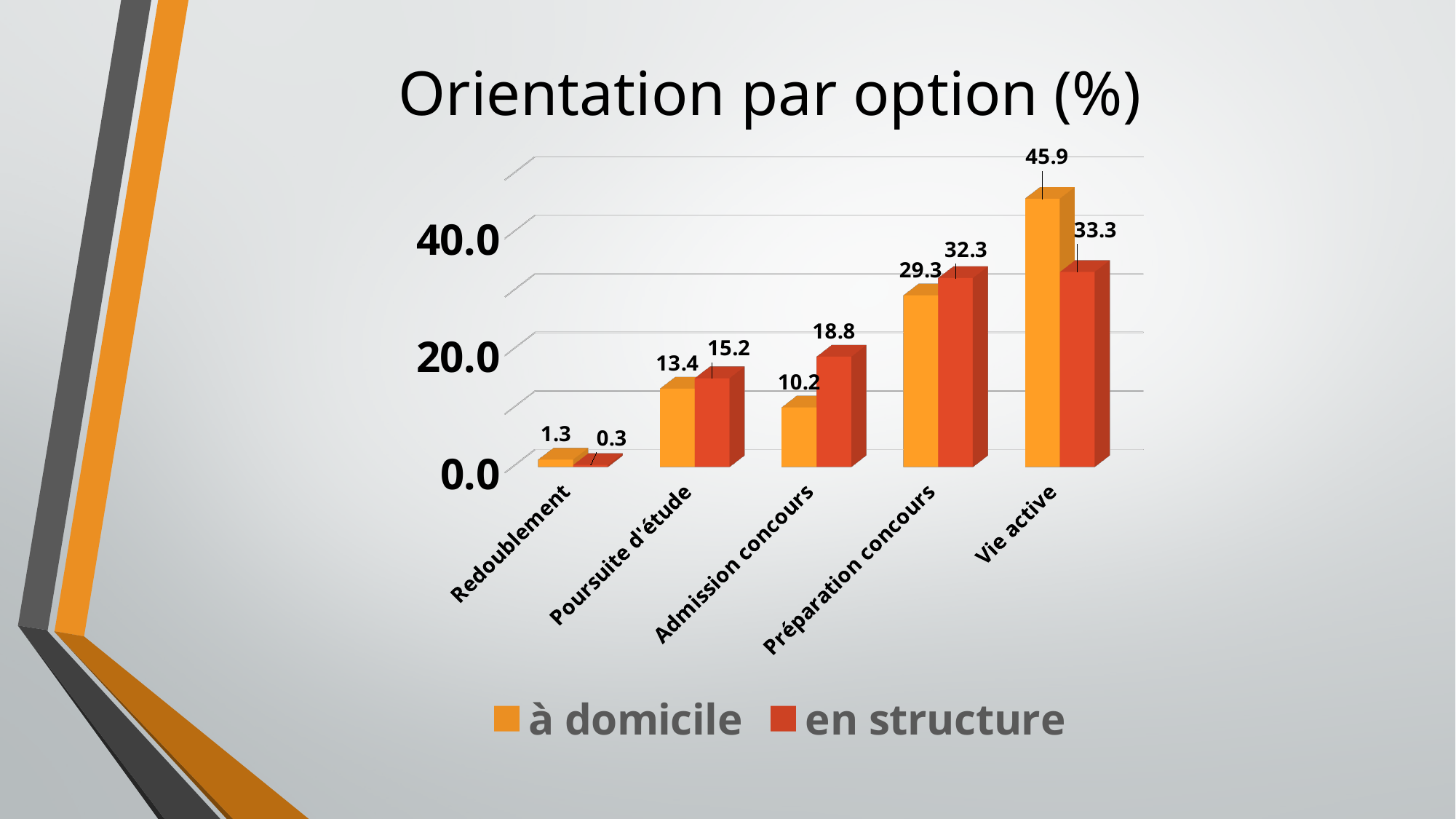
How many series does the legend list? 2 Which category has the lowest value for 'à domicile'? Redoublement What is the difference between 'à domicile' and 'en structure' in the 'Vie active' category? 12.6 What is the title of the chart? Orientation par option (%) How many categories are shown on the x axis? 5 What is the value for 'à domicile' in the 'Redoublement' category? 1.3 Which category has the highest value for 'en structure'? Vie active In the 'Préparation concours' category, which series has the larger value, 'à domicile' or 'en structure'? en structure What is the value for 'en structure' in the 'Admission concours' category? 18.8 What is the value for 'à domicile' in the 'Vie active' category? 45.9 What is the difference between 'en structure' and 'à domicile' in the 'Admission concours' category? 8.6 What kind of chart is shown on the slide? Bar chart